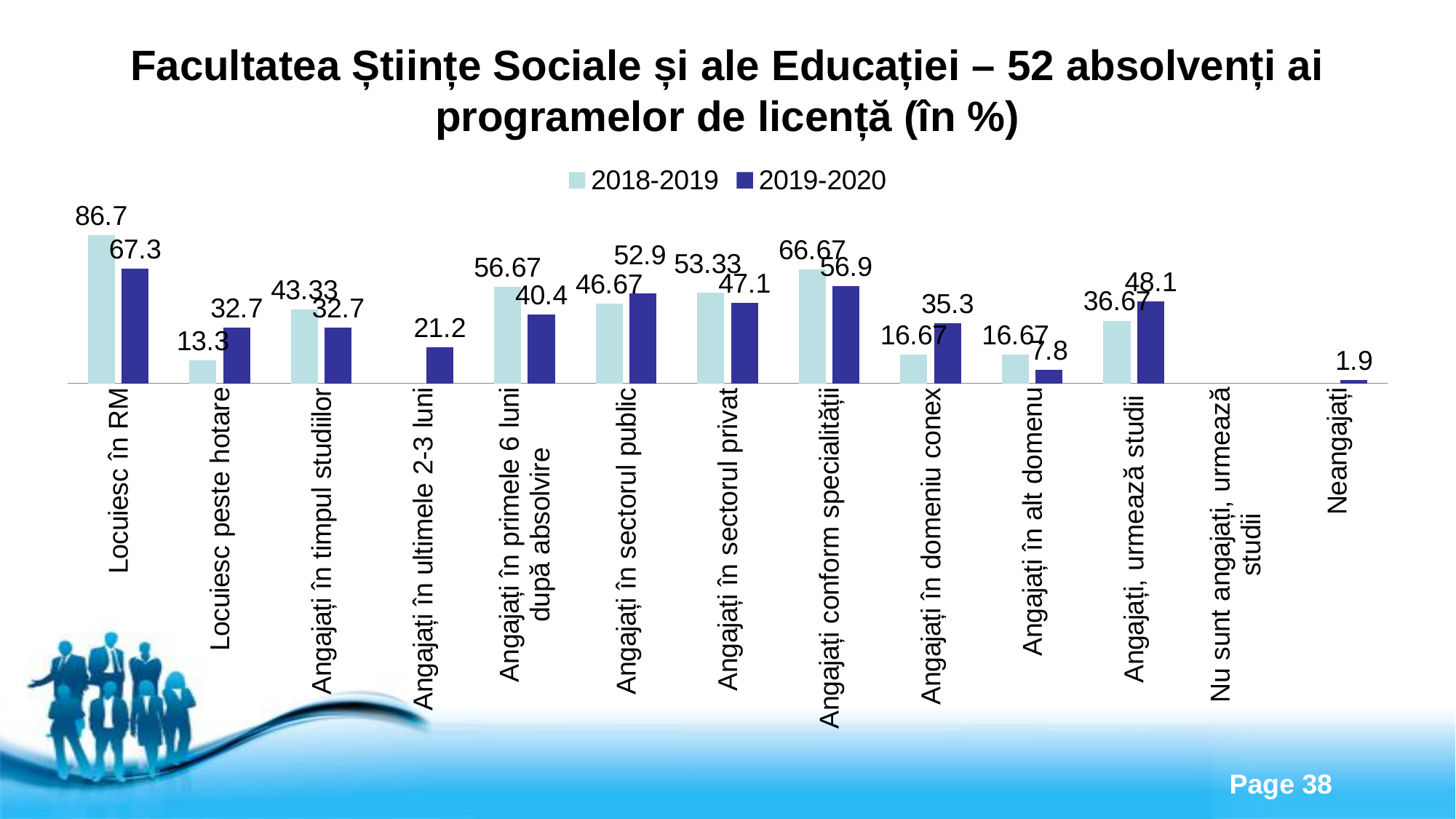
What is the difference between the 2018-2019 and 2019-2020 values for "Locuiesc în RM"? 19.4 What is the value for "Neangajați" in the 2019-2020 series? 1.9 What kind of chart is shown on the slide? Bar chart Which category has the highest value in the 2018-2019 series? Locuiesc în RM For "Angajați în sectorul public", which series has the larger value, 2018-2019 or 2019-2020? 2019-2020 What is the 2019-2020 value for "Angajați în sectorul public"? 52.9 What is the 2018-2019 value for "Angajați conform specialității"? 66.67 Which category has the lowest value in the 2019-2020 series? Neangajați How many categories are shown on the x axis of the chart? 13 How many series does the legend list? 2 What is the value for "Locuiesc în RM" in the 2018-2019 series? 86.7 For "Angajați în alt domenu", which series has the larger value, 2018-2019 or 2019-2020? 2018-2019